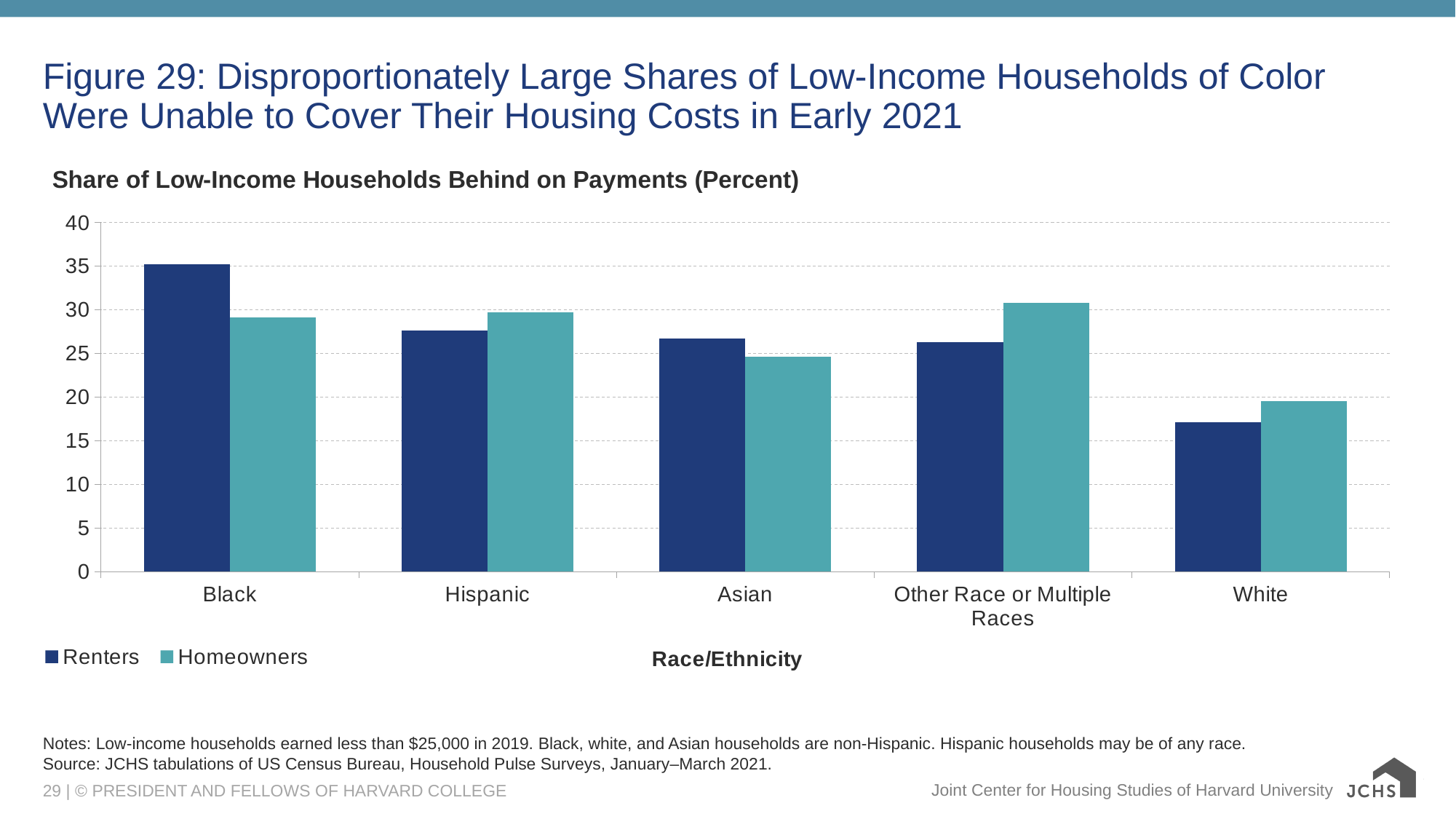
Is the value for Black renters greater or less than 30? greater How many series does the legend list? 2 For Hispanic households, which is larger: the share of renters or the share of homeowners behind on payments? Homeowners Which race/ethnicity category has the lowest share of low-income renters behind on payments? White What is the label of the x axis? Race/Ethnicity For Black households, which is larger: the share of renters or the share of homeowners behind on payments? Renters What kind of chart is shown on the slide? bar chart Which race/ethnicity category has the highest share of low-income renters behind on payments? Black For White households, which is larger: the share of renters or the share of homeowners behind on payments? Homeowners Which race/ethnicity category has the lowest share of low-income homeowners behind on payments? White Is the value for White renters greater or less than 20? less How many race/ethnicity categories are shown on the x axis? 5